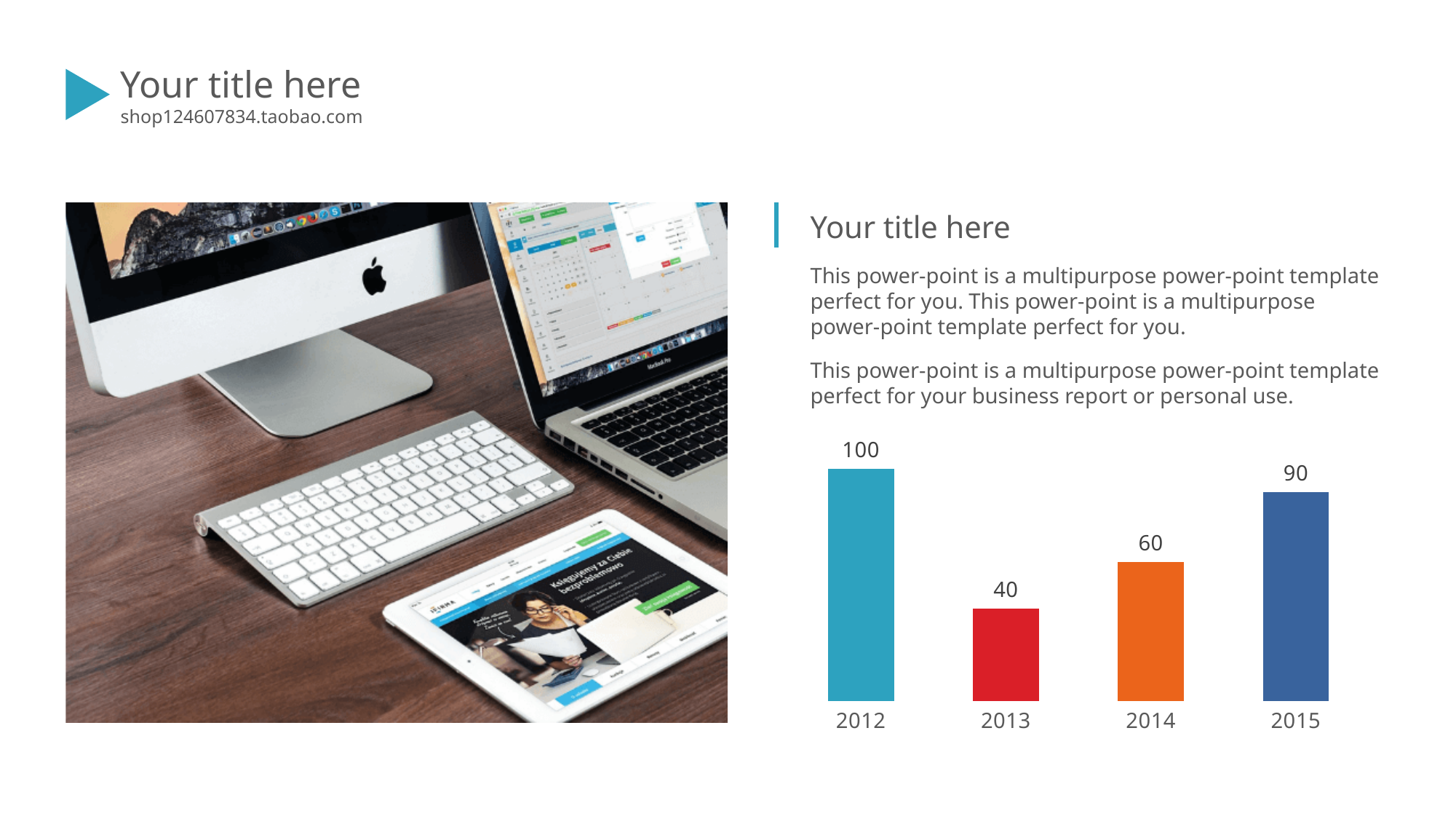
Which year has the highest value? 2012 Which year has the lowest value? 2013 What is the value for 2014? 60 What is the value for 2015? 90 What kind of chart is shown on the slide? bar chart How many years are shown on the chart? 4 Which is larger, the value for 2014 or the value for 2015? 2015 What is the difference between the values for 2012 and 2013? 60 What is the value for 2012? 100 What is the difference between the values for 2015 and 2014? 30 What is the value for 2013? 40 What colour is the bar for 2014? orange